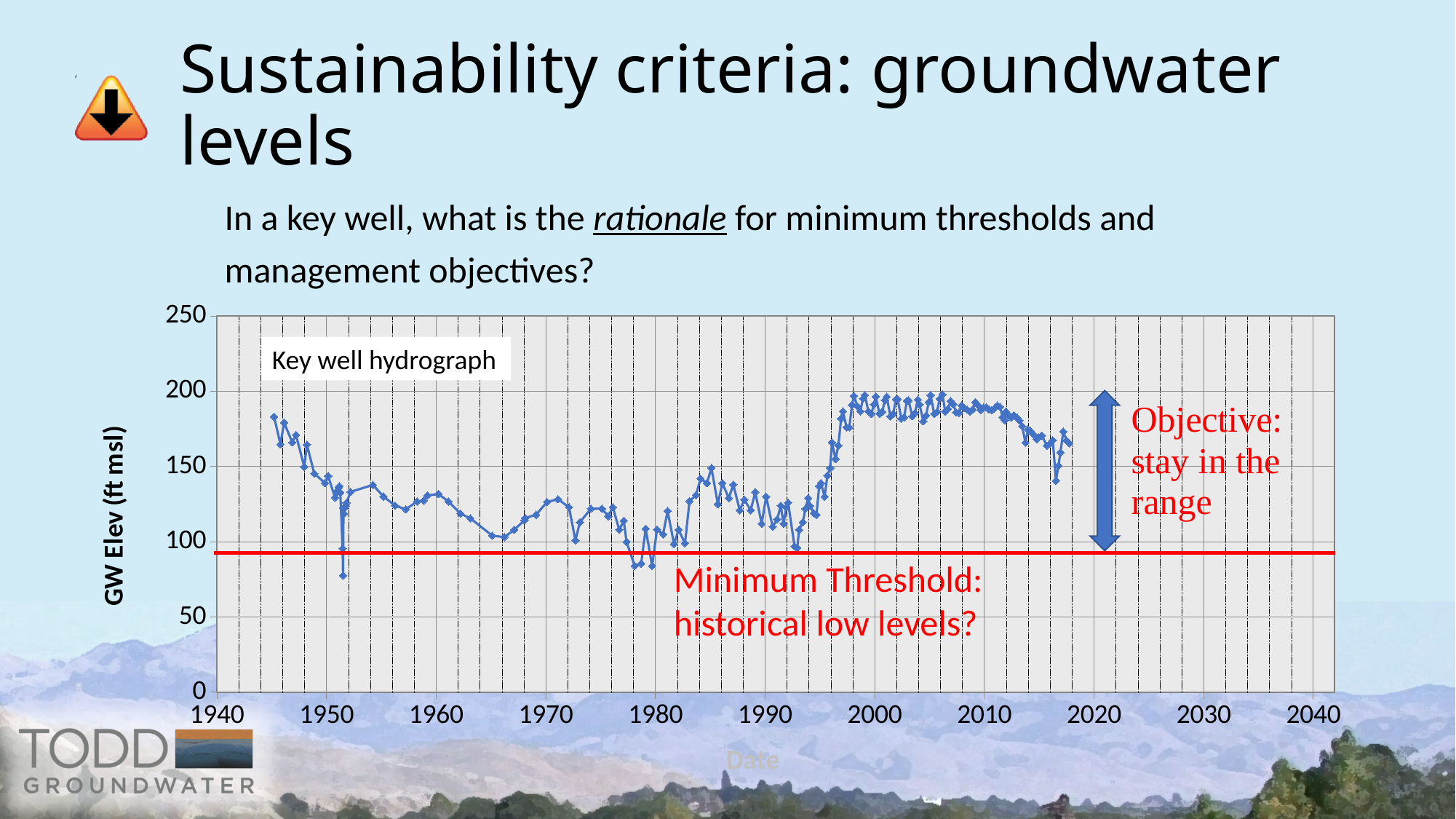
What title is shown inside the chart area? Key well hydrograph Do the groundwater elevation values rise or fall between 1945 and 1965? fall What is the label on the y axis of the chart? GW Elev (ft msl) Is the groundwater elevation around 1978 greater or less than 100? less Is the groundwater elevation around the year 2000 greater or less than 150? greater Is the groundwater elevation around 2010 greater or less than 200? less How many data series are plotted on the chart? 1 Do the groundwater elevation values rise or fall between 1993 and 2000? rise What kind of chart is shown on the slide? line chart Which period has higher groundwater elevation values: around 2000 or around 1980? around 2000